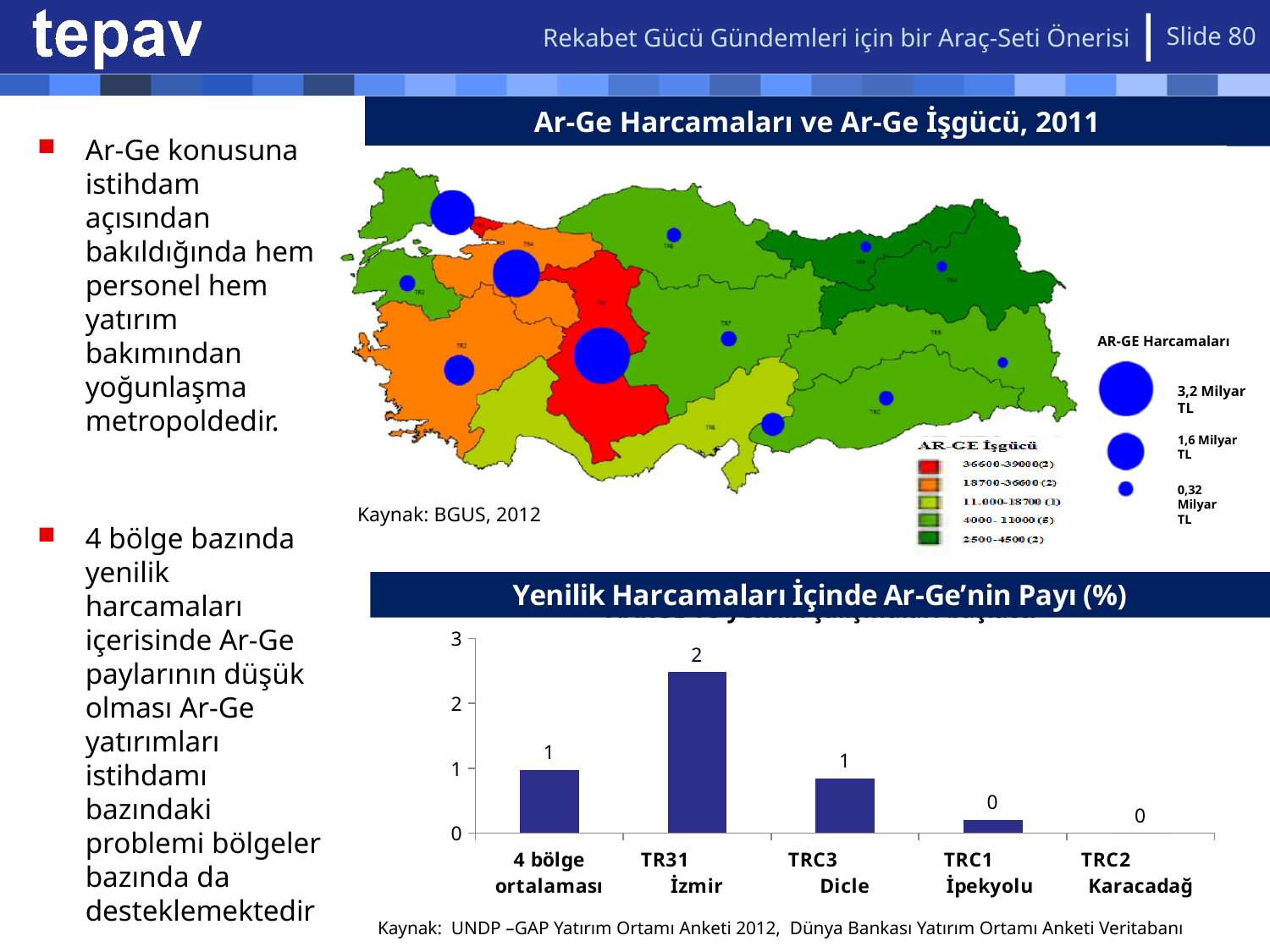
In the bar chart 'Yenilik Harcamaları İçinde Ar-Ge'nin Payı (%)', which is larger: the bar for TR31 İzmir or the bar for TRC3 Dicle? TR31 İzmir In the bar chart 'Yenilik Harcamaları İçinde Ar-Ge'nin Payı (%)', what value is labelled for TRC3 Dicle? 1 In the map chart 'Ar-Ge Harcamaları ve Ar-Ge İşgücü, 2011', what value does the largest circle in the 'AR-GE Harcamaları' legend represent? 3,2 Milyar TL In the bar chart 'Yenilik Harcamaları İçinde Ar-Ge'nin Payı (%)', is the bar for TR31 İzmir greater or less than 2? greater In the bar chart 'Yenilik Harcamaları İçinde Ar-Ge'nin Payı (%)', what value is labelled for TR31 İzmir? 2 How many regions (categories) are shown in the bar chart 'Yenilik Harcamaları İçinde Ar-Ge'nin Payı (%)'? 5 In the bar chart 'Yenilik Harcamaları İçinde Ar-Ge'nin Payı (%)', which region has the highest bar? TR31 İzmir In the bar chart 'Yenilik Harcamaları İçinde Ar-Ge'nin Payı (%)', what value is labelled for TRC1 İpekyolu? 0 In the bar chart 'Yenilik Harcamaları İçinde Ar-Ge'nin Payı (%)', what value is labelled for '4 bölge ortalaması'? 1 In the bar chart 'Yenilik Harcamaları İçinde Ar-Ge'nin Payı (%)', is the bar for TRC1 İpekyolu greater or less than 1? less In the bar chart 'Yenilik Harcamaları İçinde Ar-Ge'nin Payı (%)', which region has the lowest bar? TRC2 Karacadağ What kind of chart is the lower chart titled 'Yenilik Harcamaları İçinde Ar-Ge'nin Payı (%)'? bar chart